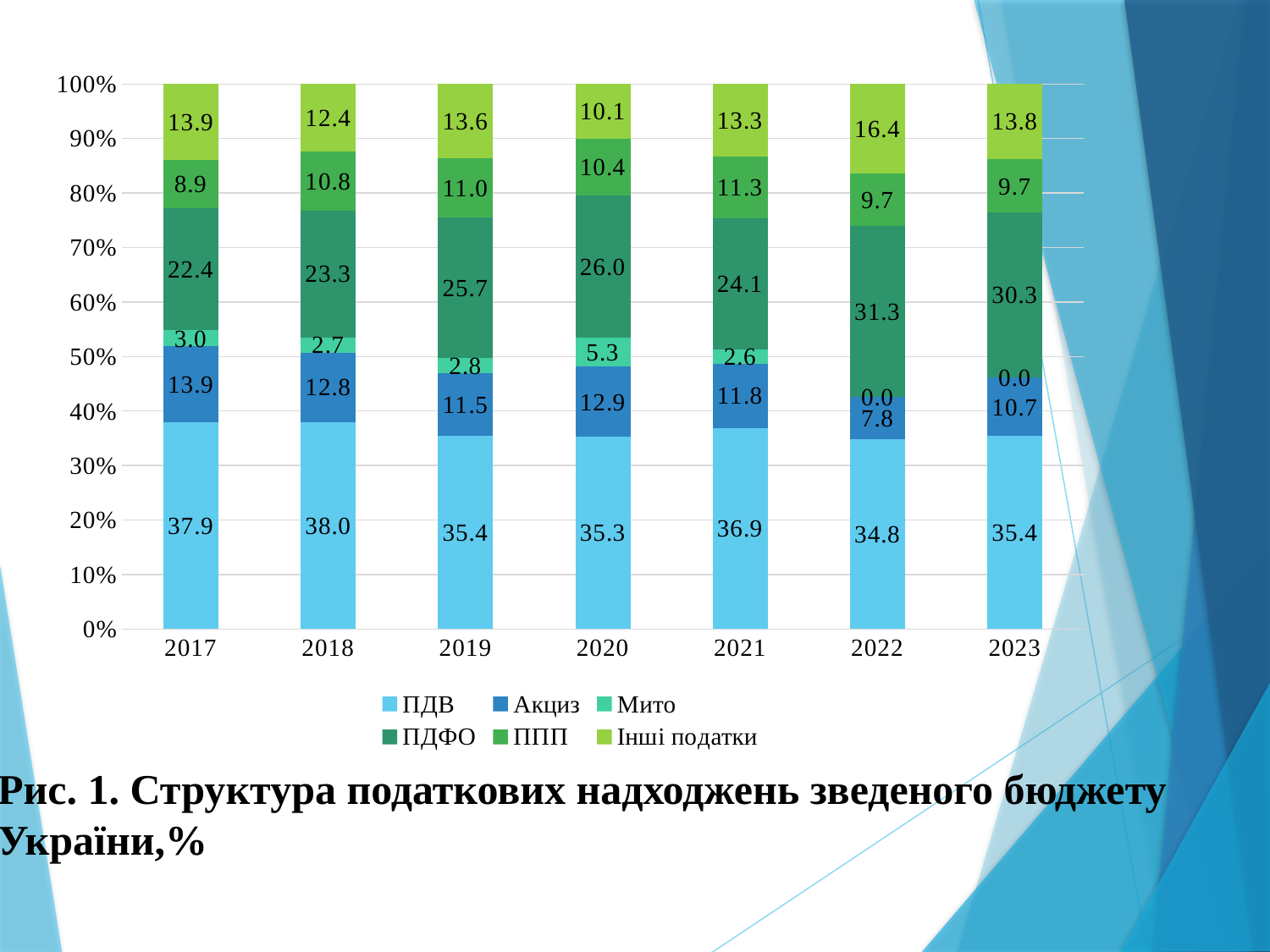
What is the value for ПДФО in 2022? 31.3 In which year is the ПДФО share highest? 2022 How many series does the legend list? 6 In which year is the Акциз share lowest? 2022 What is the difference between the ПДВ values for 2018 and 2022? 3.2 How many years are shown on the x axis? 7 Which is larger, the ППП value in 2019 or the ППП value in 2022? 2019 What is the value for Мито in 2022? 0.0 What kind of chart is shown on the slide? Stacked bar chart What is the value for Інші податки in 2023? 13.8 What is the value for Мито in 2020? 5.3 What is the value for ПДВ in 2017? 37.9